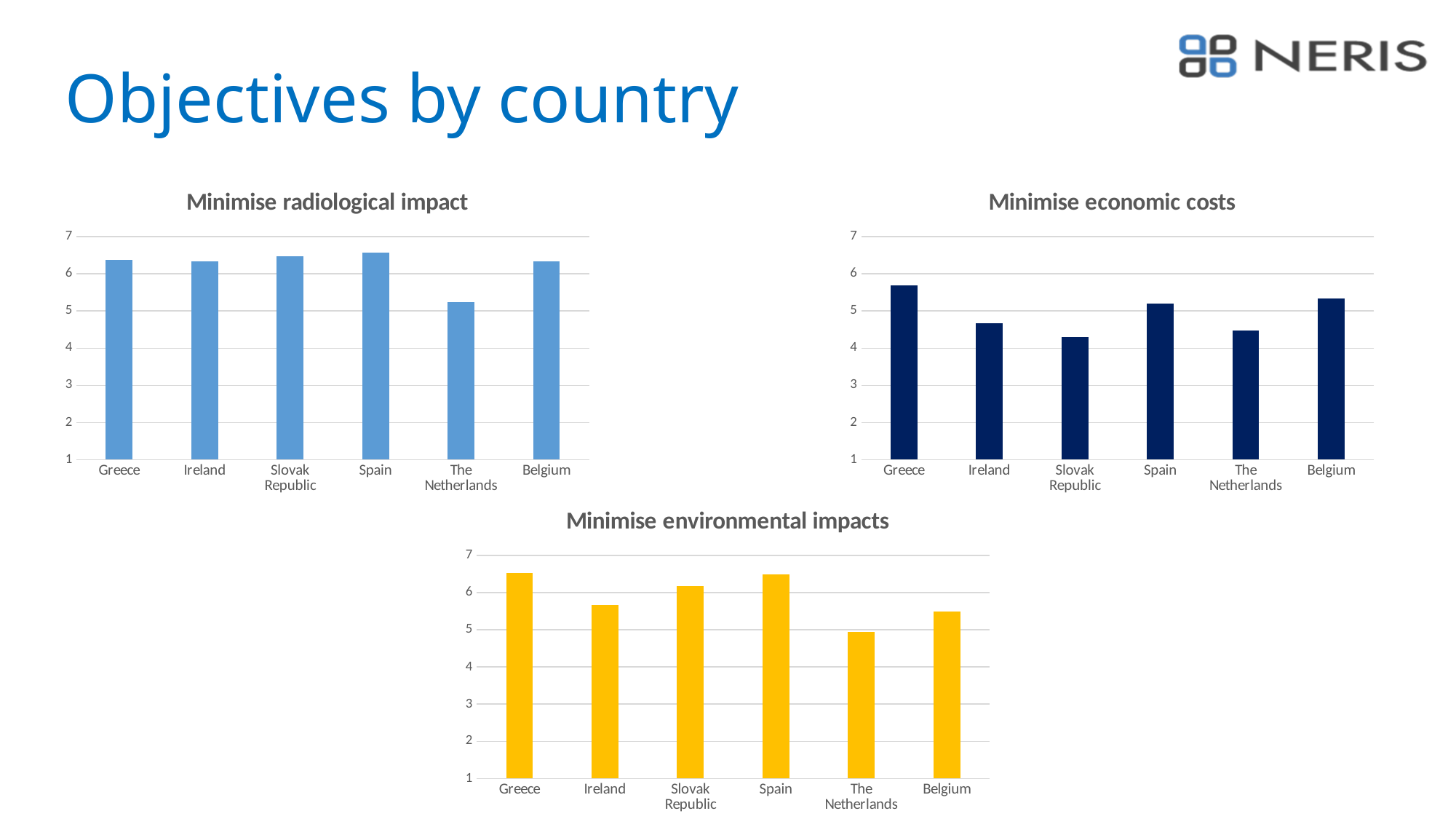
In the 'Minimise economic costs' chart, which country has the highest value? Greece In the 'Minimise environmental impacts' chart, is the value for Ireland greater or less than 5? greater In the 'Minimise environmental impacts' chart, which country has the lowest value? The Netherlands How many countries are shown in the 'Minimise economic costs' chart? 6 In the 'Minimise environmental impacts' chart, which is larger, the value for Slovak Republic or the value for Ireland? Slovak Republic In the 'Minimise economic costs' chart, is the value for Slovak Republic greater or less than 5? less In the 'Minimise radiological impact' chart, is the value for The Netherlands greater or less than 5? greater In the 'Minimise radiological impact' chart, which country has the lowest value? The Netherlands What type of chart is the 'Minimise environmental impacts' chart? bar chart In the 'Minimise economic costs' chart, which is larger, the value for Greece or the value for Ireland? Greece What colour are the bars in the 'Minimise environmental impacts' chart? yellow